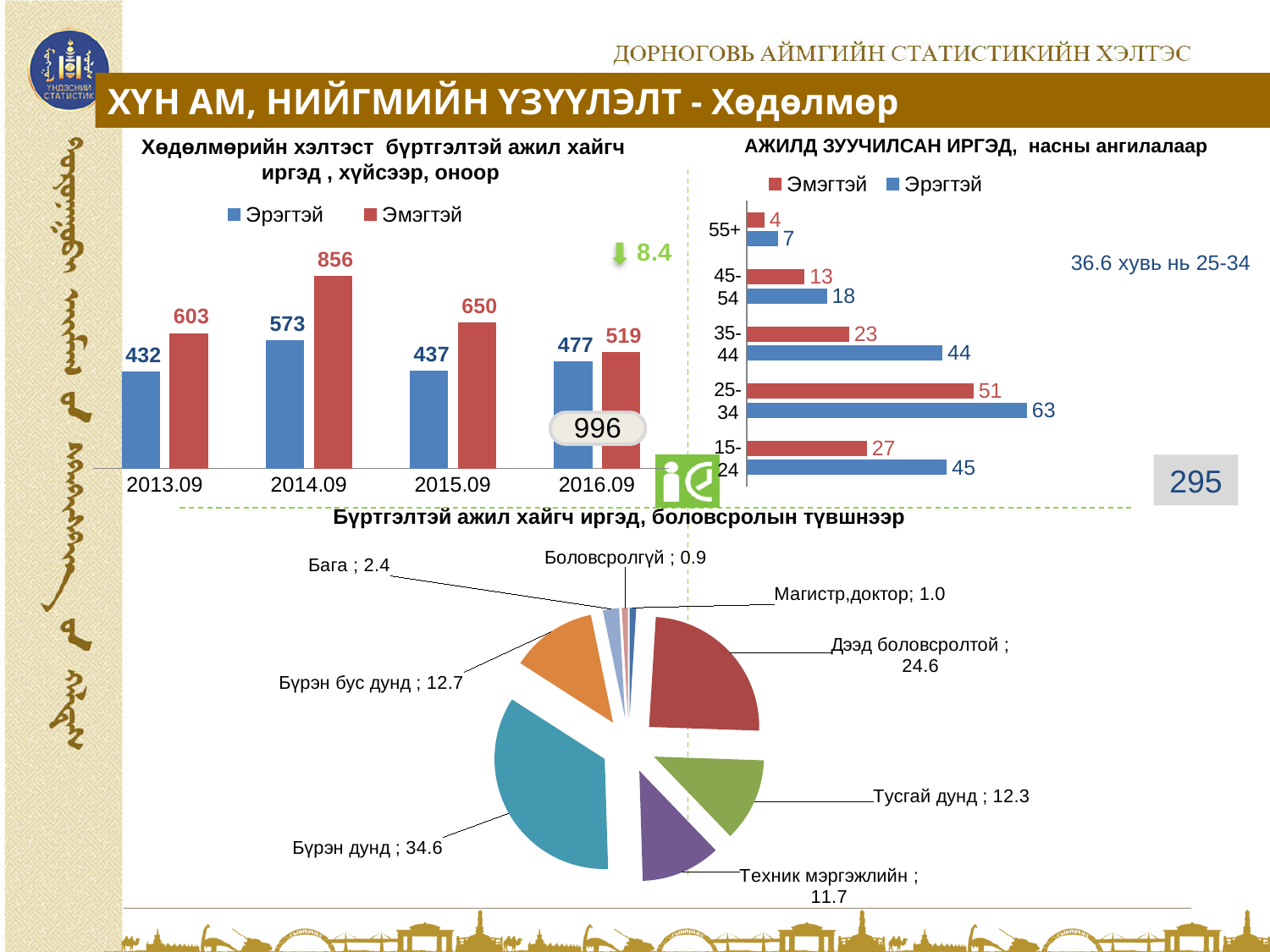
In the top-right chart (АЖИЛД ЗУУЧИЛСАН ИРГЭД, насны ангилалаар), which age group has the lowest Эрэгтэй value? 55+ What kind of chart is the bottom chart (Бүртгэлтэй ажил хайгч иргэд, боловсролын түвшнээр)? pie chart In the top-left chart (Хөдөлмөрийн хэлтэст бүртгэлтэй ажил хайгч иргэд, хүйсээр, оноор), how many series does the legend list? 2 In the top-right chart (АЖИЛД ЗУУЧИЛСАН ИРГЭД, насны ангилалаар), what is the Эмэгтэй value for the 45-54 age group? 13 In the top-left chart (Хөдөлмөрийн хэлтэст бүртгэлтэй ажил хайгч иргэд, хүйсээр, оноор), which year has the highest Эмэгтэй value? 2014.09 In the top-right chart (АЖИЛД ЗУУЧИЛСАН ИРГЭД, насны ангилалаар), which is larger for the 15-24 age group, Эмэгтэй or Эрэгтэй? Эрэгтэй In the top-left chart (Хөдөлмөрийн хэлтэст бүртгэлтэй ажил хайгч иргэд, хүйсээр, оноор), what is the value for Эмэгтэй in 2014.09? 856 In the bottom chart (Бүртгэлтэй ажил хайгч иргэд, боловсролын түвшнээр), what is the value for Бүрэн дунд? 34.6 In the top-left chart (Хөдөлмөрийн хэлтэст бүртгэлтэй ажил хайгч иргэд, хүйсээр, оноор), what is the difference between the Эмэгтэй and Эрэгтэй values in 2015.09? 213 In the top-right chart (АЖИЛД ЗУУЧИЛСАН ИРГЭД, насны ангилалаар), how many age groups are shown? 5 In the top-left chart (Хөдөлмөрийн хэлтэст бүртгэлтэй ажил хайгч иргэд, хүйсээр, оноор), what is the value for Эрэгтэй in 2016.09? 477 In the top-right chart (АЖИЛД ЗУУЧИЛСАН ИРГЭД, насны ангилалаар), what is the Эрэгтэй value for the 25-34 age group? 63